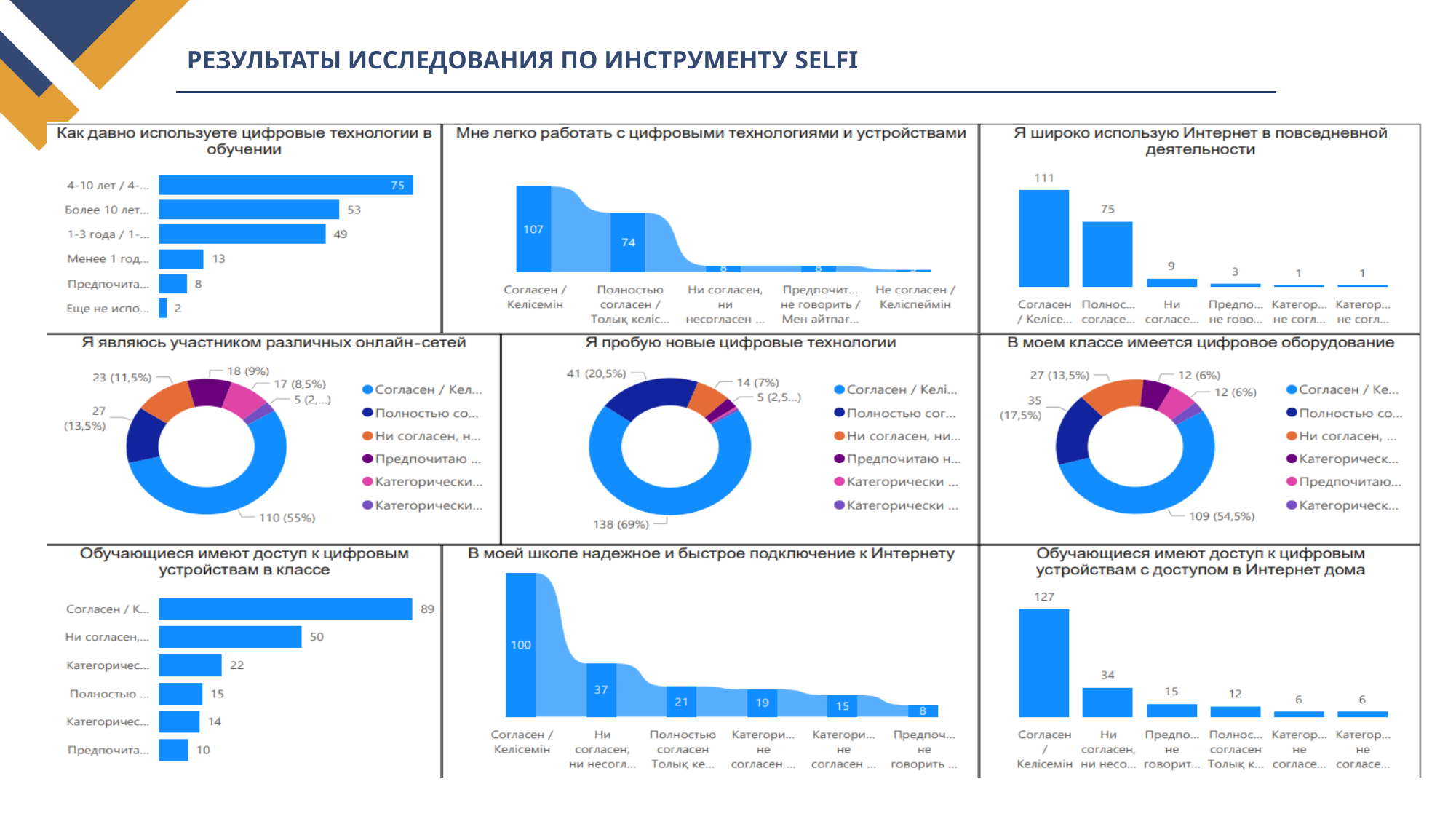
In the chart 'Как давно используете цифровые технологии в обучении', how many categories are shown? 6 In the chart 'В моей школе надежное и быстрое подключение к Интернету', what is the value for 'Ни согласен, ни несогласен'? 37 In the chart 'В моем классе имеется цифровое оборудование', how many series does the legend list? 6 In the chart 'Как давно используете цифровые технологии в обучении', what is the difference between 'Более 10 лет' and '1-3 года'? 4 In the chart 'Я являюсь участником различных онлайн-сетей', what share does the largest slice represent? 55% In the chart 'Как давно используете цифровые технологии в обучении', what is the value for '4-10 лет'? 75 What kind of chart is 'Обучающиеся имеют доступ к цифровым устройствам в классе'? bar chart In the chart 'Мне легко работать с цифровыми технологиями и устройствами', what is the value for 'Согласен / Келісемін'? 107 In the chart 'Обучающиеся имеют доступ к цифровым устройствам с доступом в Интернет дома', is the value for 'Согласен / Келісемін' larger than the value for 'Ни согласен, ни несогласен'? Yes, 127 vs 34 In the chart 'Я пробую новые цифровые технологии', what is the value of the largest slice? 138 (69%) In the chart 'Я широко использую Интернет в повседневной деятельности', which category has the highest value? Согласен / Келісемін In the chart 'Я широко использую Интернет в повседневной деятельности', what is the value for 'Полностью согласен'? 75